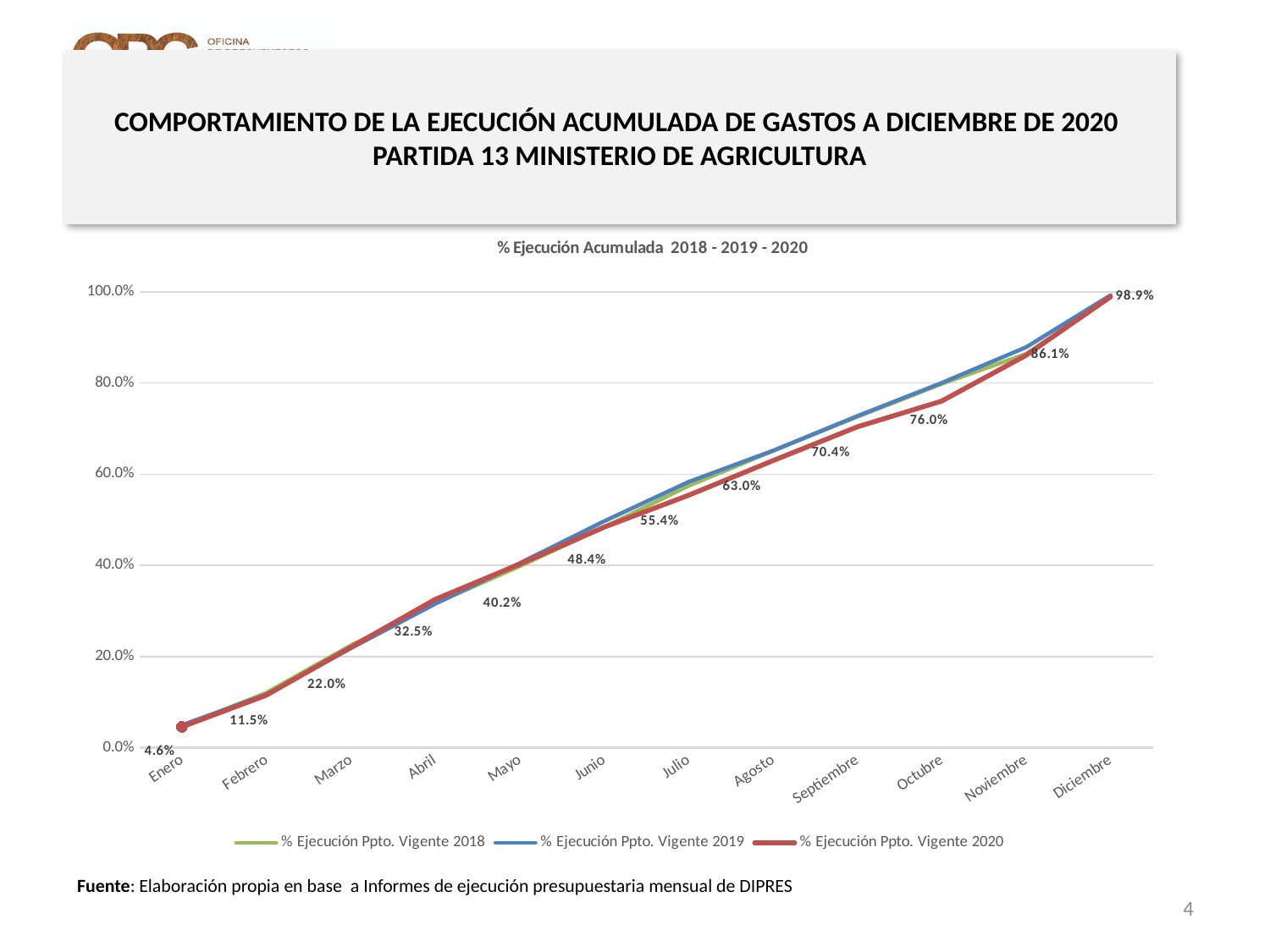
What is the difference between the Diciembre and Noviembre values in the % Ejecución Ppto. Vigente 2020 series? 12.8% What is the value for Diciembre in the % Ejecución Ppto. Vigente 2020 series? 98.9% How many months are shown on the x axis of the chart? 12 What is the value for Enero in the % Ejecución Ppto. Vigente 2020 series? 4.6% Which month has the lowest value in the % Ejecución Ppto. Vigente 2020 series? Enero What kind of chart is shown on the slide? Line chart What is the value for Junio in the % Ejecución Ppto. Vigente 2020 series? 48.4% Which month has the highest value in the % Ejecución Ppto. Vigente 2020 series? Diciembre How many series does the chart legend list? 3 In Octubre, which series has the larger value: % Ejecución Ppto. Vigente 2019 or % Ejecución Ppto. Vigente 2020? % Ejecución Ppto. Vigente 2019 Is the value for Septiembre in the % Ejecución Ppto. Vigente 2019 series greater or less than 60.0%? greater What is the value for Octubre in the % Ejecución Ppto. Vigente 2020 series? 76.0%